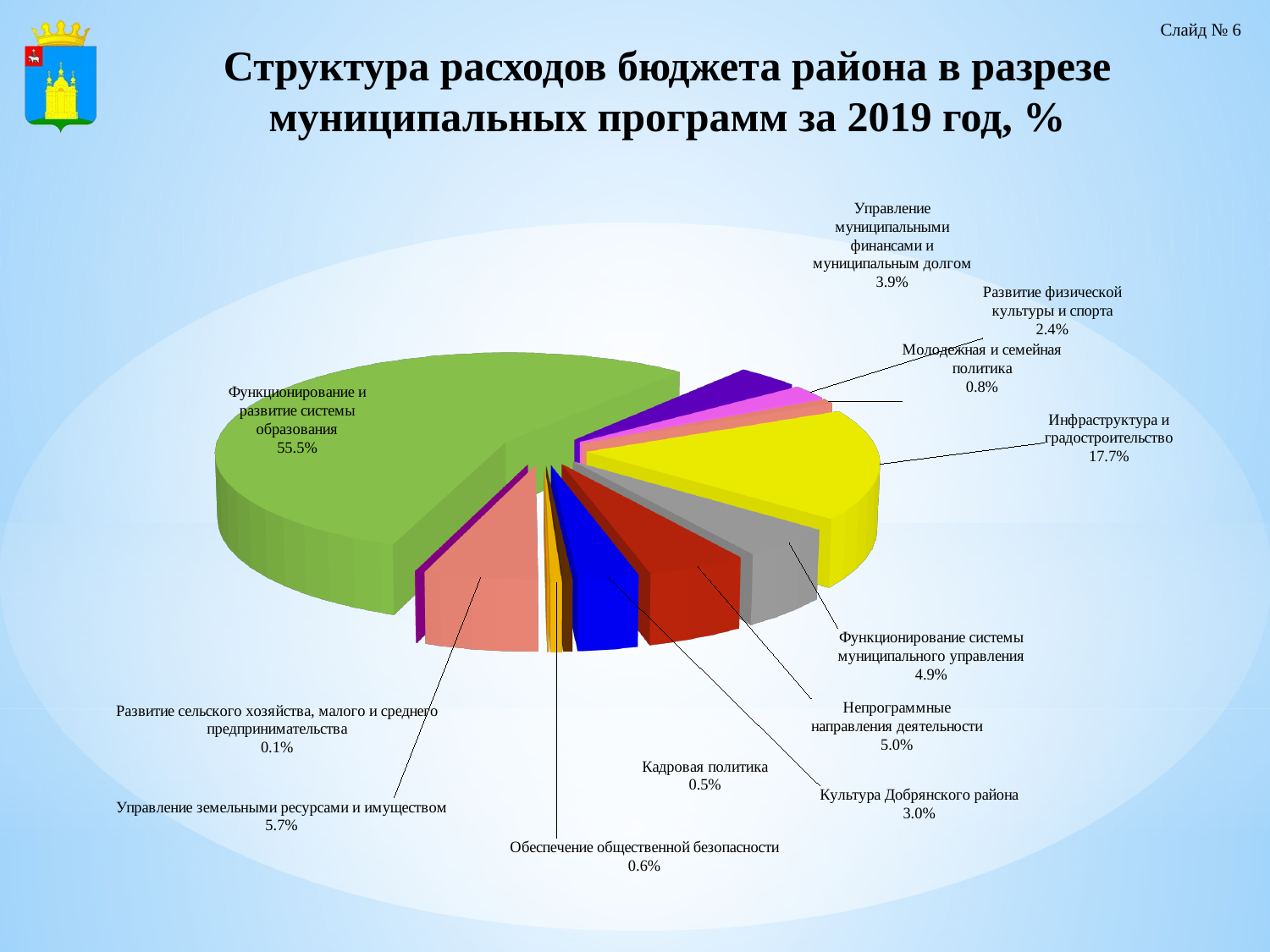
Which has a larger share: «Управление муниципальными финансами и муниципальным долгом» or «Развитие физической культуры и спорта»? Управление муниципальными финансами и муниципальным долгом What is the difference in percentage points between «Функционирование и развитие системы образования» and «Инфраструктура и градостроительство»? 37.8 Which category has the largest share of the budget expenditures? Функционирование и развитие системы образования What is the share of «Культура Добрянского района»? 3.0% What type of chart is shown on the slide? Pie chart What is the share of «Инфраструктура и градостроительство»? 17.7% What is the title of the chart on the slide? Структура расходов бюджета района в разрезе муниципальных программ за 2019 год, % Which category has the smallest share of the budget expenditures? Развитие сельского хозяйства, малого и среднего предпринимательства What is the share of «Управление земельными ресурсами и имуществом»? 5.7% What is the share of «Обеспечение общественной безопасности»? 0.6% What is the share of «Функционирование и развитие системы образования» in the pie chart? 55.5% How many categories (slices) does the pie chart contain? 13